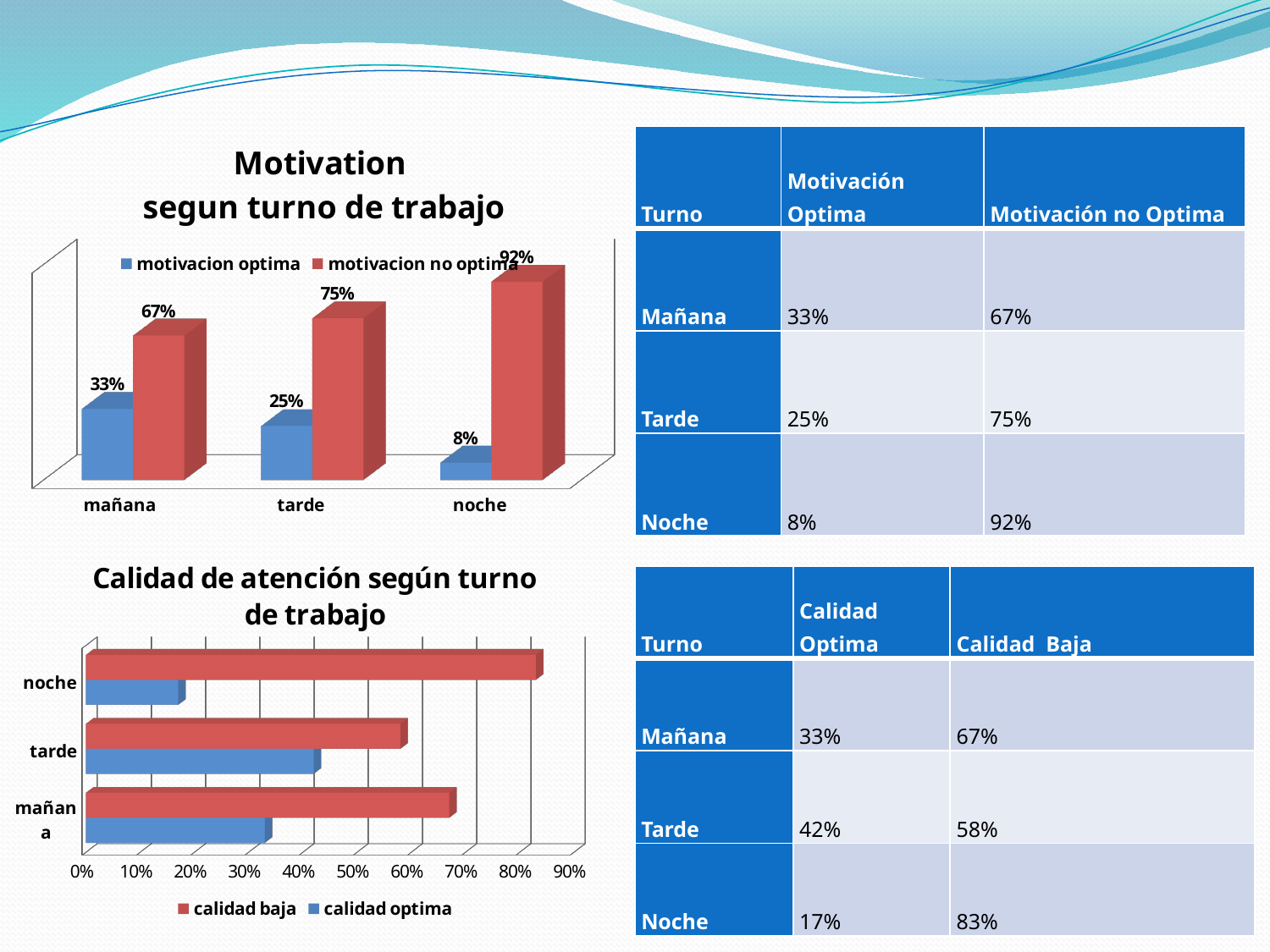
In the chart 'Motivation segun turno de trabajo', what is the value for motivacion no optima in the noche shift? 92% In the chart 'Motivation segun turno de trabajo', what is the difference between motivacion no optima and motivacion optima for the tarde shift? 50% In the chart 'Motivation segun turno de trabajo', which shift has the highest motivacion no optima value? noche In the chart 'Motivation segun turno de trabajo', how many series does the legend list? 2 In the chart 'Calidad de atención según turno de trabajo', which shift has the highest calidad baja value? noche In the chart 'Calidad de atención según turno de trabajo', how many shifts are shown on the vertical axis? 3 In the chart 'Motivation segun turno de trabajo', what is the value for motivacion optima in the mañana shift? 33% In the chart 'Calidad de atención según turno de trabajo', is the calidad baja value for noche greater or less than 80%? greater In the chart 'Motivation segun turno de trabajo', which shift has the lowest motivacion optima value? noche What kind of chart is 'Calidad de atención según turno de trabajo'? bar chart In the chart 'Calidad de atención según turno de trabajo', is the calidad optima value for noche greater or less than 20%? less In the chart 'Motivation segun turno de trabajo', does motivacion optima rise or fall from mañana to noche? fall